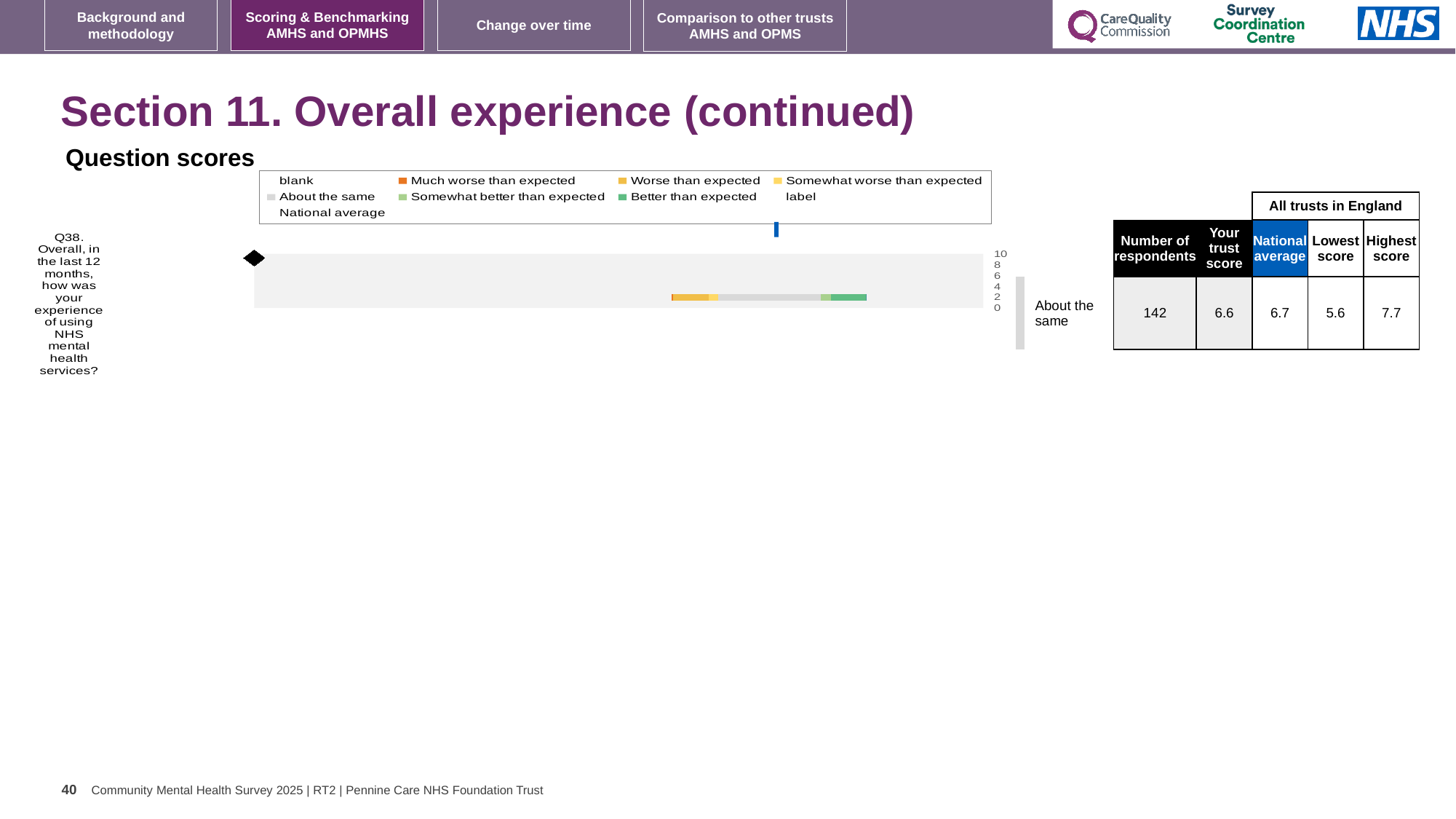
What is the highest value shown on the chart's axis? 10 What benchmark category label is shown to the right of the Q38 bar? About the same How many questions (categories) are plotted in the chart? 1 What kind of chart is shown under 'Question scores'? bar chart Which question number is plotted in the chart? Q38